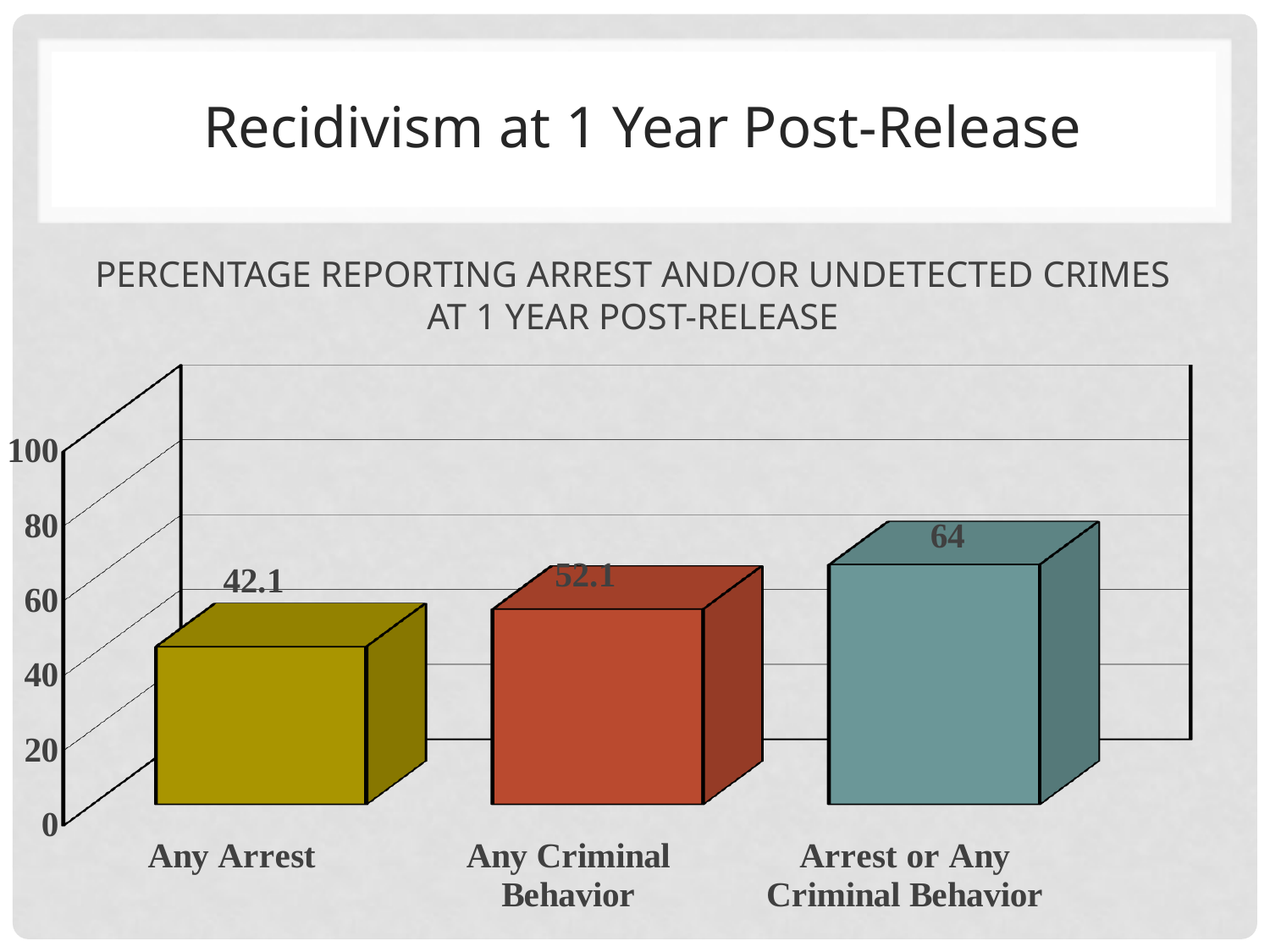
Do the values rise or fall from left to right across the categories? Rise Which category has the highest value? Arrest or Any Criminal Behavior What is the value for Arrest or Any Criminal Behavior? 64 Which category has the lowest value? Any Arrest What is the value for Any Criminal Behavior? 52.1 What is the value for Any Arrest? 42.1 Is the value for Arrest or Any Criminal Behavior greater or less than 60? greater What is the difference between the values for Arrest or Any Criminal Behavior and Any Arrest? 21.9 What kind of chart is shown on the slide? Bar chart How many categories are shown in the chart? 3 Which is larger, the value for Any Criminal Behavior or the value for Any Arrest? Any Criminal Behavior What is the difference between the values for Any Criminal Behavior and Any Arrest? 10